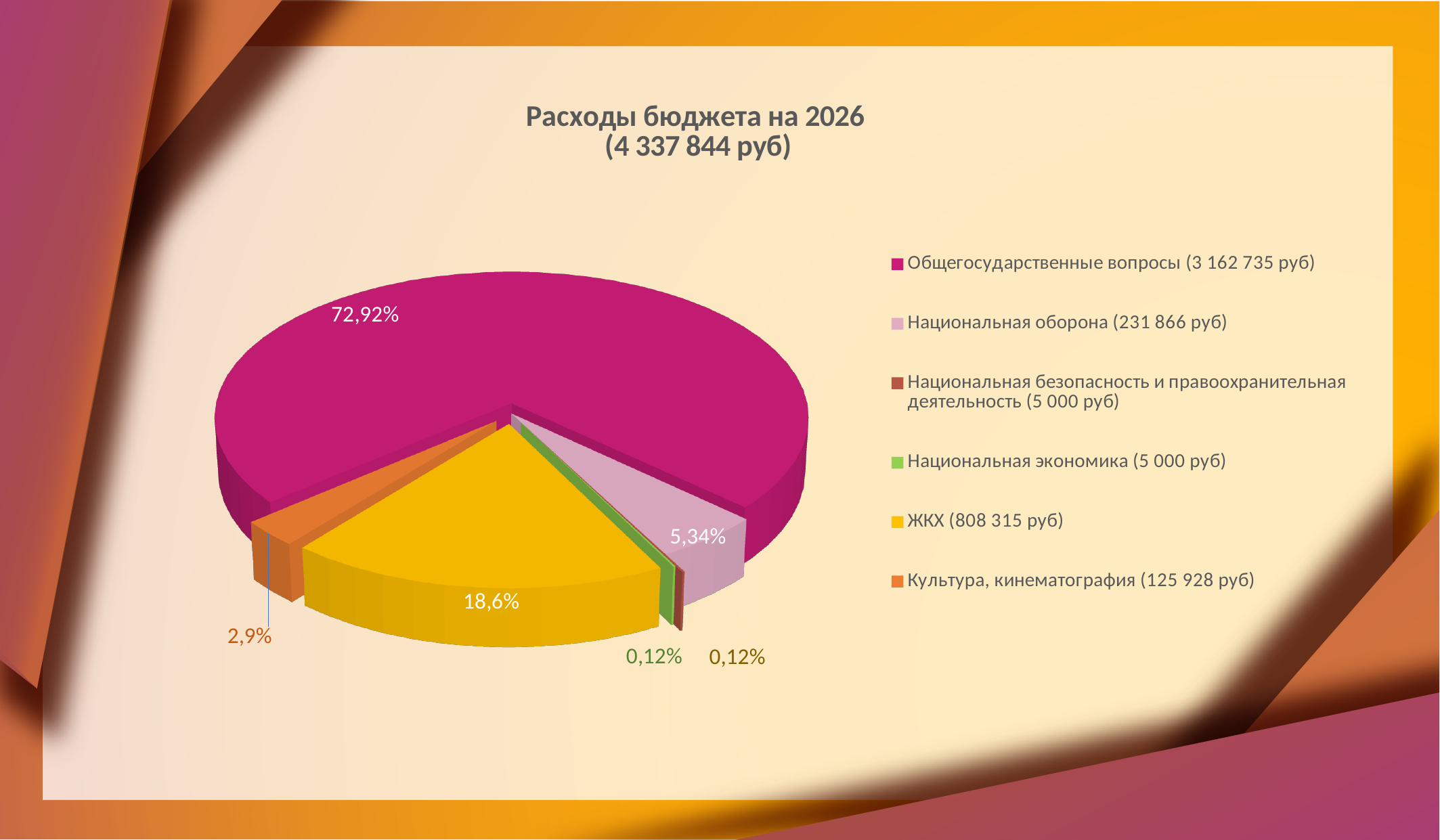
What share of the pie does Национальная оборона take? 5,34% What amount in rubles is shown in the legend for Национальная оборона? 231 866 руб What kind of chart is shown on the slide? Pie chart What share of the pie does Национальная экономика take? 0,12% What share of the pie does Общегосударственные вопросы take? 72,92% Which category has the largest share of the pie? Общегосударственные вопросы Which is larger, the share for ЖКХ or the share for Национальная оборона? ЖКХ What amount in rubles is shown in the legend for ЖКХ? 808 315 руб How many categories does the legend list? 6 What is the title of the chart? Расходы бюджета на 2026 (4 337 844 руб)